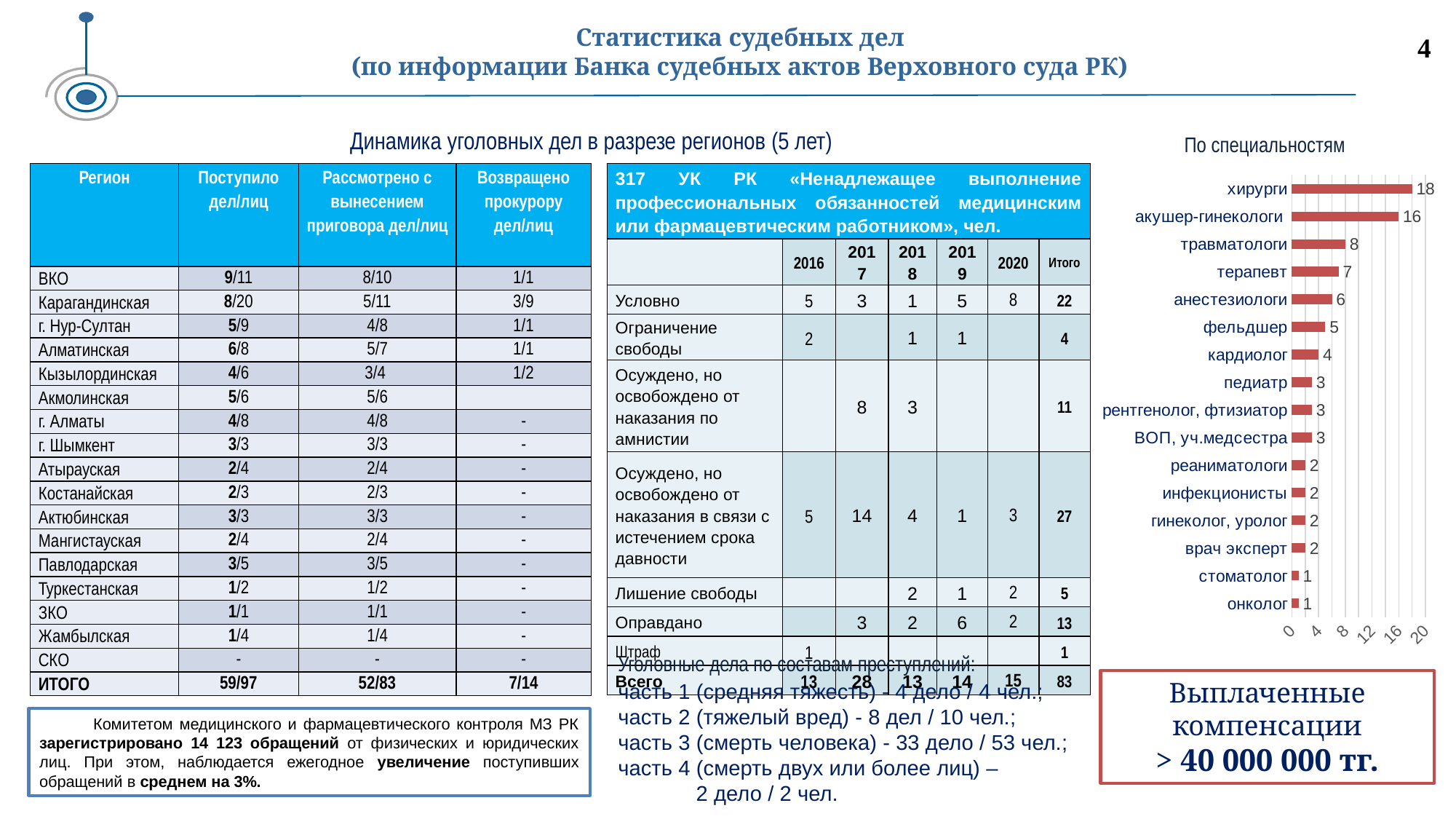
In the "По специальностям" chart, is the value for акушер-гинекологи greater or less than 12? greater In the "По специальностям" chart, which specialty has the highest value? хирурги In the "По специальностям" chart, what is the value for акушер-гинекологи? 16 How many specialties (categories) are shown in the "По специальностям" chart? 16 In the "По специальностям" chart, what is the value for фельдшер? 5 In the "По специальностям" chart, what is the value for терапевт? 7 In the "По специальностям" chart, what is the value for хирурги? 18 What is the highest tick value shown on the horizontal axis of the "По специальностям" chart? 20 In the "По специальностям" chart, what is the difference between the values for хирурги and травматологи? 10 In the "По специальностям" chart, what is the value for педиатр? 3 In the "По специальностям" chart, which is larger: the value for анестезиологи or the value for кардиолог? анестезиологи What type of chart is shown under the title "По специальностям"? bar chart